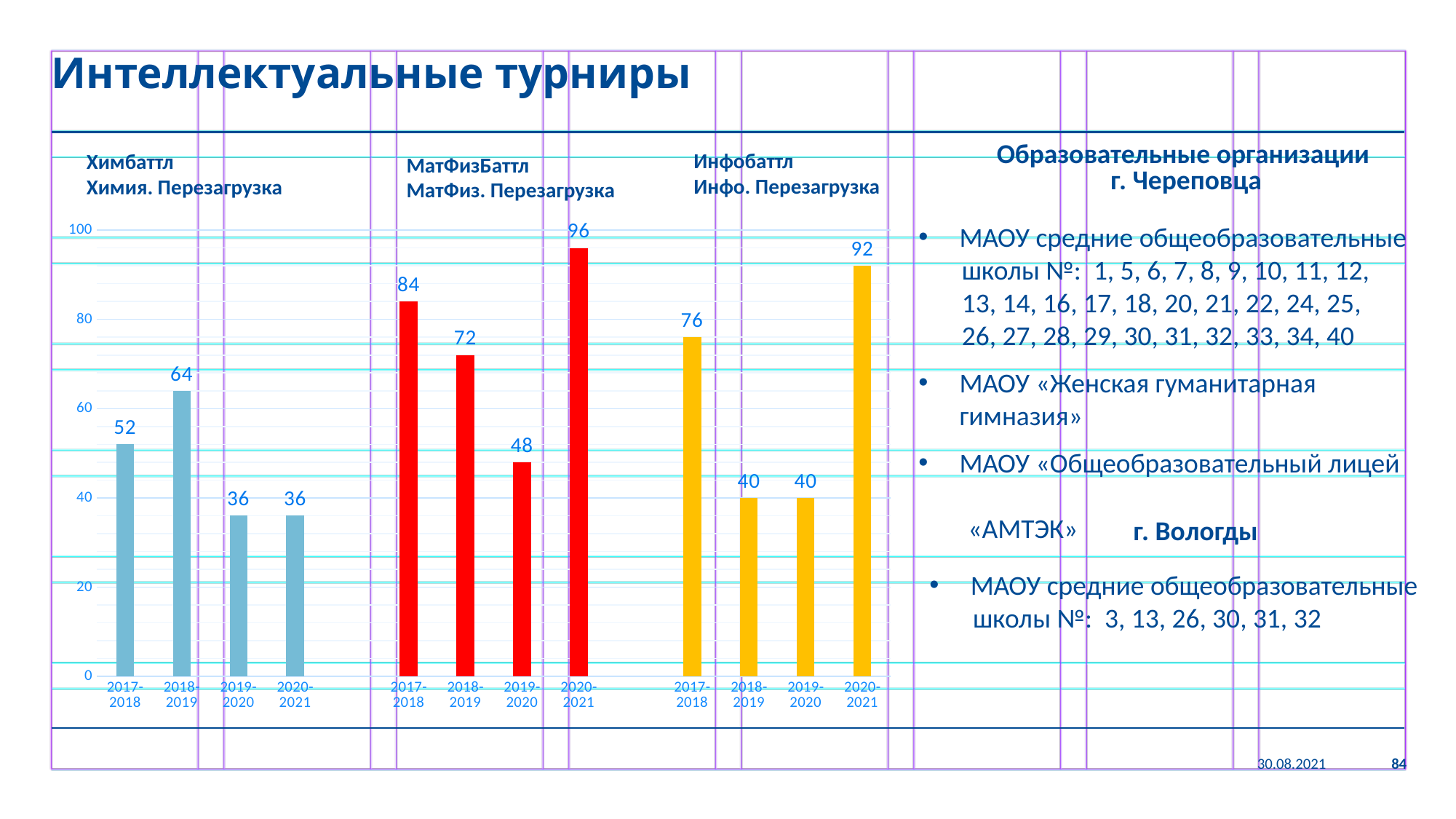
What kind of chart is shown on the slide? bar chart What value is shown for МатФизБаттл in 2020-2021? 96 How many bars are plotted in the chart in total? 12 Which is larger: the Химбаттл value for 2017-2018 or the МатФизБаттл value for 2019-2020? Химбаттл 2017-2018 What value is shown for Инфобаттл in 2017-2018? 76 Which year has the lowest value in the МатФизБаттл group? 2019-2020 What is the difference between the Инфобаттл values for 2020-2021 and 2017-2018? 16 Which year has the highest value in the МатФизБаттл group? 2020-2021 Do the Химбаттл values rise or fall from 2018-2019 to 2019-2020? fall Is the value for Инфобаттл in 2018-2019 greater or less than 60? less What colour are the bars in the Инфобаттл group? yellow What value is shown for Химбаттл in 2018-2019? 64